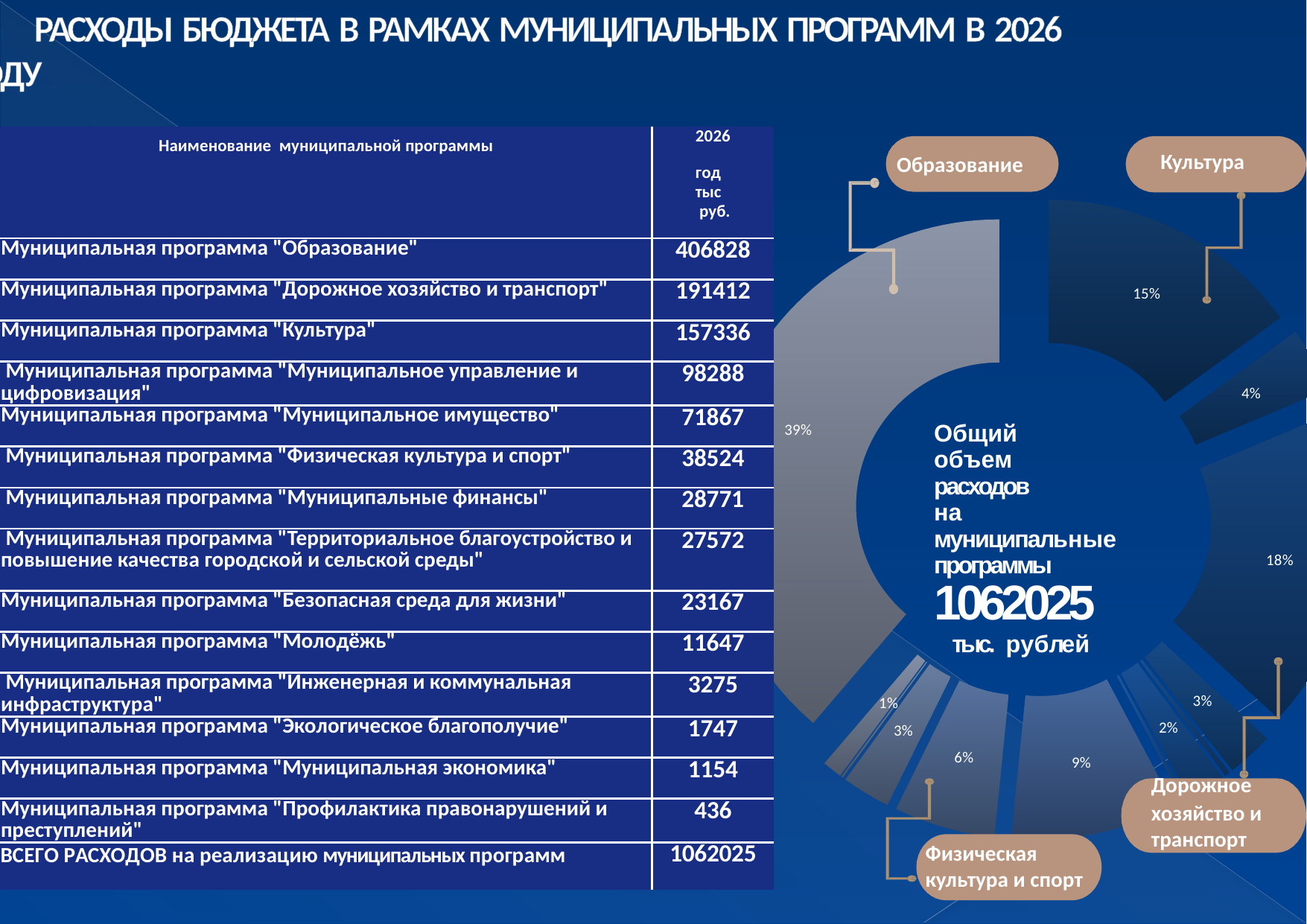
By how many percentage points does the "Образование" slice exceed the "Культура" slice in the pie chart? 24 In the pie chart, what share is labelled for the slice with the callout "Образование"? 39% What total value is printed in the centre of the pie chart? 1062025 тыс. рублей What kind of chart is shown on the right side of the slide? pie chart (donut) What does the text in the centre of the pie chart say the total represents? Общий объем расходов на муниципальные программы In the pie chart, what share is labelled for the slice with the callout "Дорожное хозяйство и транспорт"? 18% Which labelled slice of the pie chart is the largest? Образование How many callout labels with program names are attached to the pie chart? 4 In the pie chart, what share is labelled for the slice with the callout "Культура"? 15% What is the smallest percentage label shown on the pie chart? 1% In the pie chart, which slice is larger: "Культура" or "Дорожное хозяйство и транспорт"? Дорожное хозяйство и транспорт